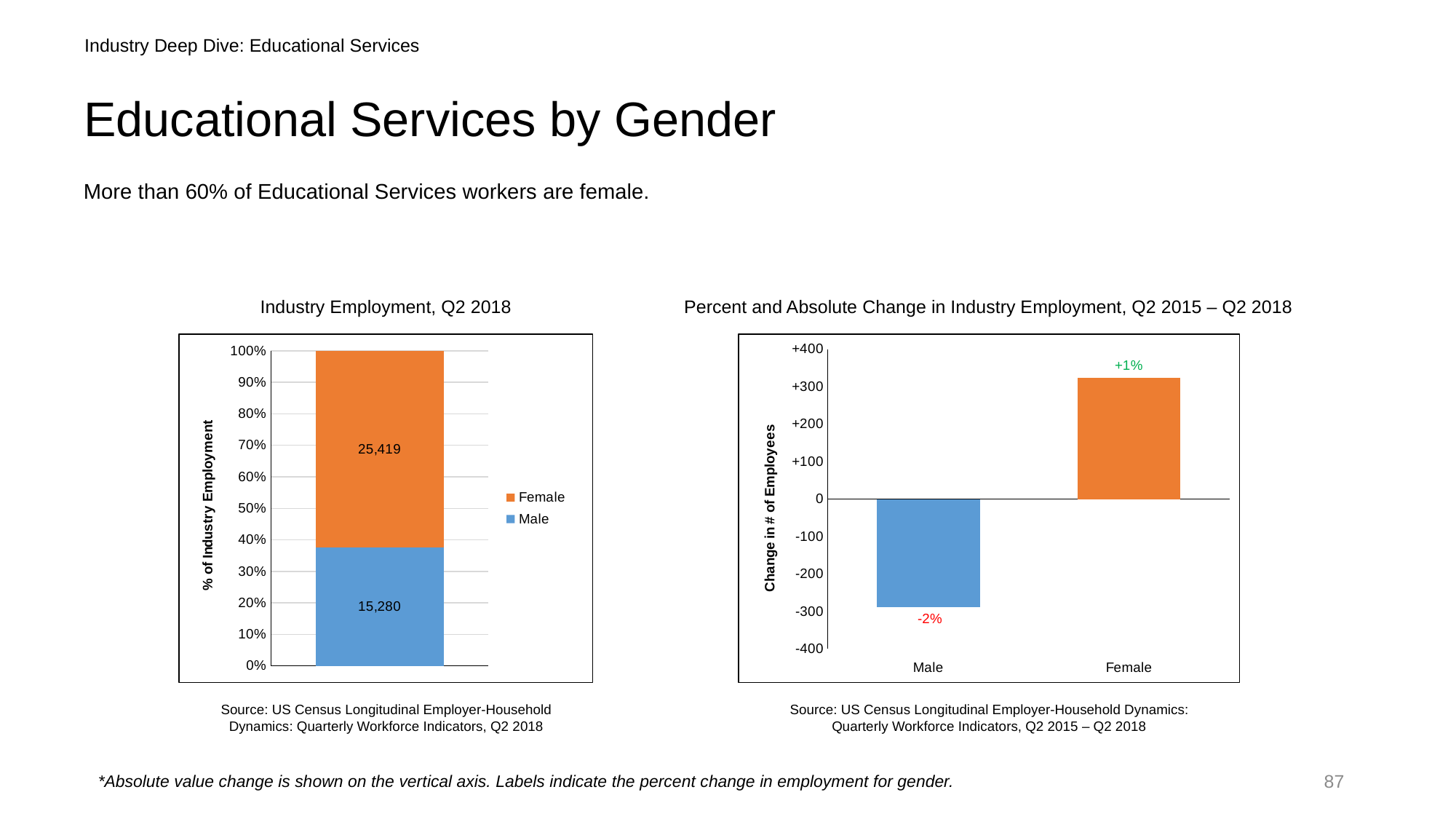
How many categories are shown on the x axis of the 'Percent and Absolute Change in Industry Employment, Q2 2015 – Q2 2018' chart? 2 What type of chart is the 'Industry Employment, Q2 2018' chart? Stacked bar chart In the 'Industry Employment, Q2 2018' chart, what is the value shown for Male? 15,280 In the 'Industry Employment, Q2 2018' chart, which gender has the larger number of employees? Female In the 'Percent and Absolute Change in Industry Employment, Q2 2015 – Q2 2018' chart, what percent change label is shown for Male? -2% In the 'Percent and Absolute Change in Industry Employment, Q2 2015 – Q2 2018' chart, is the change in number of employees for Female greater or less than +200? greater In the 'Industry Employment, Q2 2018' chart, what is the value shown for Female? 25,419 How many series does the legend of the 'Industry Employment, Q2 2018' chart list? 2 In the 'Percent and Absolute Change in Industry Employment, Q2 2015 – Q2 2018' chart, is the change in number of employees for Male greater or less than -200? less In the 'Industry Employment, Q2 2018' chart, what is the difference between the Female and Male values? 10,139 In the 'Industry Employment, Q2 2018' chart, what is the total of the stacked bar? 40,699 In the 'Percent and Absolute Change in Industry Employment, Q2 2015 – Q2 2018' chart, what percent change label is shown for Female? +1%